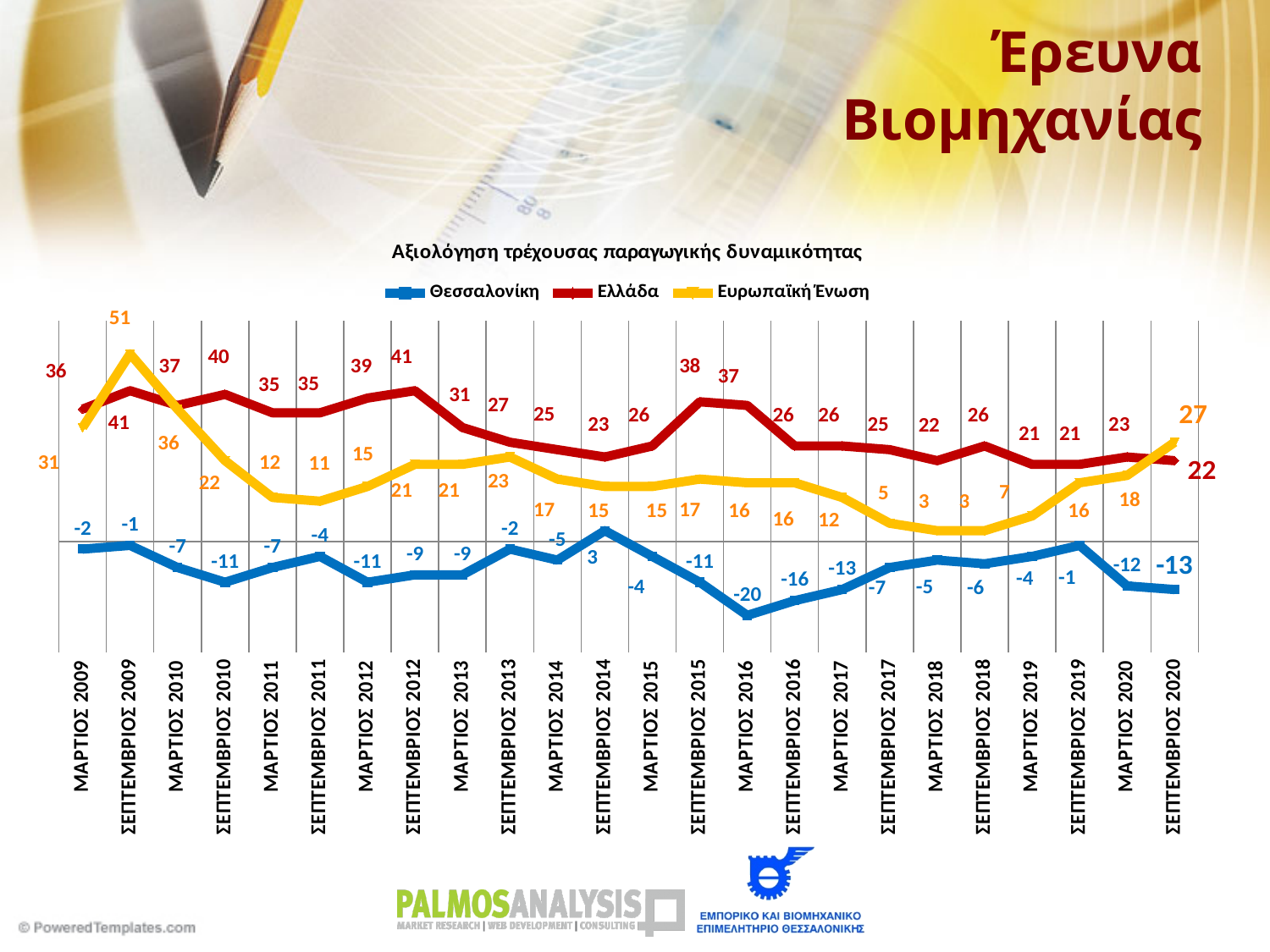
What is the difference between the Ελλάδα and Ευρωπαϊκή Ένωση values in ΜΑΡΤΙΟΣ 2018? 19 Does the Θεσσαλονίκη value rise or fall from ΣΕΠΤΕΜΒΡΙΟΣ 2019 to ΣΕΠΤΕΜΒΡΙΟΣ 2020? Fall What kind of chart is shown on the slide? Line chart At which time point does Θεσσαλονίκη reach its lowest value? ΜΑΡΤΙΟΣ 2016 What is the value for Ελλάδα in ΣΕΠΤΕΜΒΡΙΟΣ 2015? 38 In ΣΕΠΤΕΜΒΡΙΟΣ 2020, which series has the higher value, Ελλάδα or Ευρωπαϊκή Ένωση? Ευρωπαϊκή Ένωση What is the value for Θεσσαλονίκη in ΣΕΠΤΕΜΒΡΙΟΣ 2020? -13 What is the title of the chart? Αξιολόγηση τρέχουσας παραγωγικής δυναμικότητας How many series does the legend list? 3 What is the value for Ευρωπαϊκή Ένωση in ΣΕΠΤΕΜΒΡΙΟΣ 2020? 27 At which time point does Ευρωπαϊκή Ένωση reach its highest value? ΣΕΠΤΕΜΒΡΙΟΣ 2009 How many time points are shown on the x axis? 24